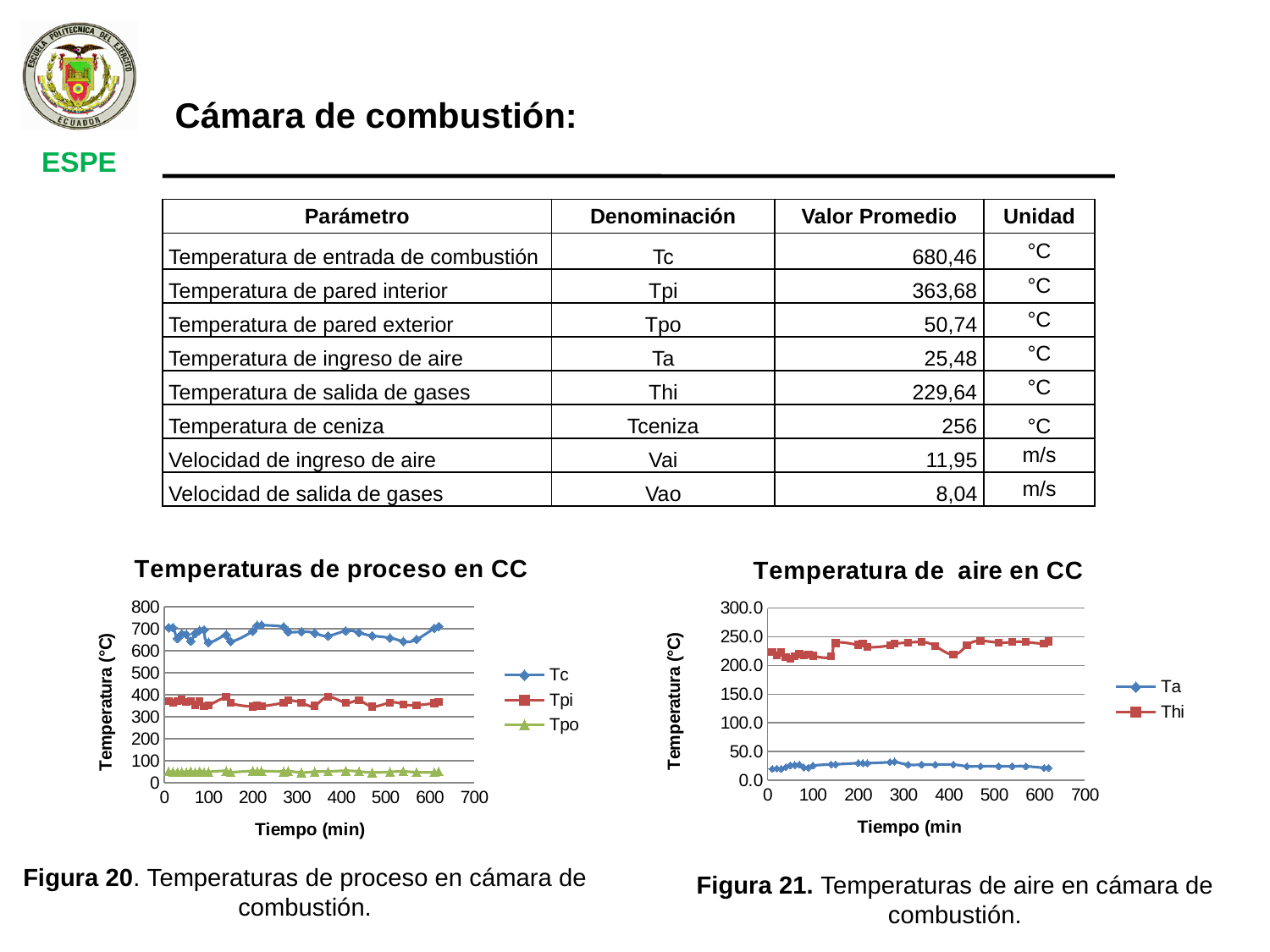
In "Temperaturas de proceso en CC", is the value of Tc at 0 min greater or less than 600? greater In "Temperaturas de proceso en CC", which series has the lowest values overall? Tpo What kind of chart is "Temperaturas de proceso en CC"? line chart How many series does the legend of "Temperaturas de proceso en CC" list? 3 What is the x-axis title of "Temperaturas de proceso en CC"? Tiempo (min) In "Temperaturas de proceso en CC", which series has the highest values, Tc or Tpo? Tc In "Temperaturas de proceso en CC", are the Tpo values greater or less than 100? less In "Temperatura de aire en CC", is the value of Thi at 600 min greater or less than 200.0? greater In "Temperatura de aire en CC", which series has higher values, Ta or Thi? Thi How many series does the legend of "Temperatura de aire en CC" list? 2 What are the legend entries in "Temperaturas de proceso en CC"? Tc, Tpi, Tpo